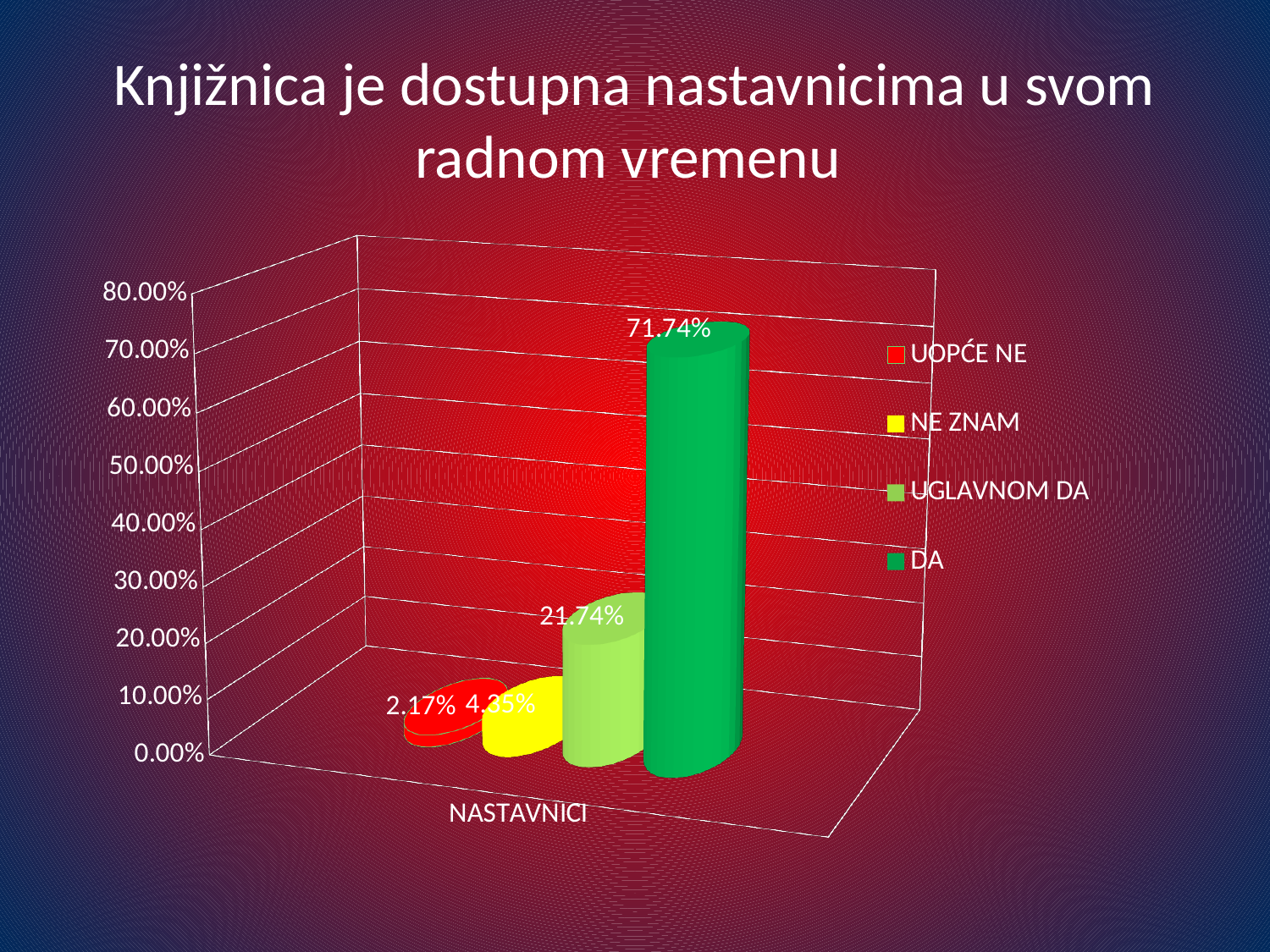
What is the category label shown on the x axis? NASTAVNICI What is the value for DA? 71.74% What is the difference between the values for DA and UGLAVNOM DA? 50.00% Which series has the lowest value? UOPĆE NE Is the value for DA greater or less than 70.00%? greater Which is larger, the value for NE ZNAM or the value for UOPĆE NE? NE ZNAM What kind of chart is shown on the slide? bar chart How many series does the legend list? 4 Which series has the highest value? DA What is the value for UGLAVNOM DA? 21.74% What is the value for NE ZNAM? 4.35% What is the value for UOPĆE NE? 2.17%